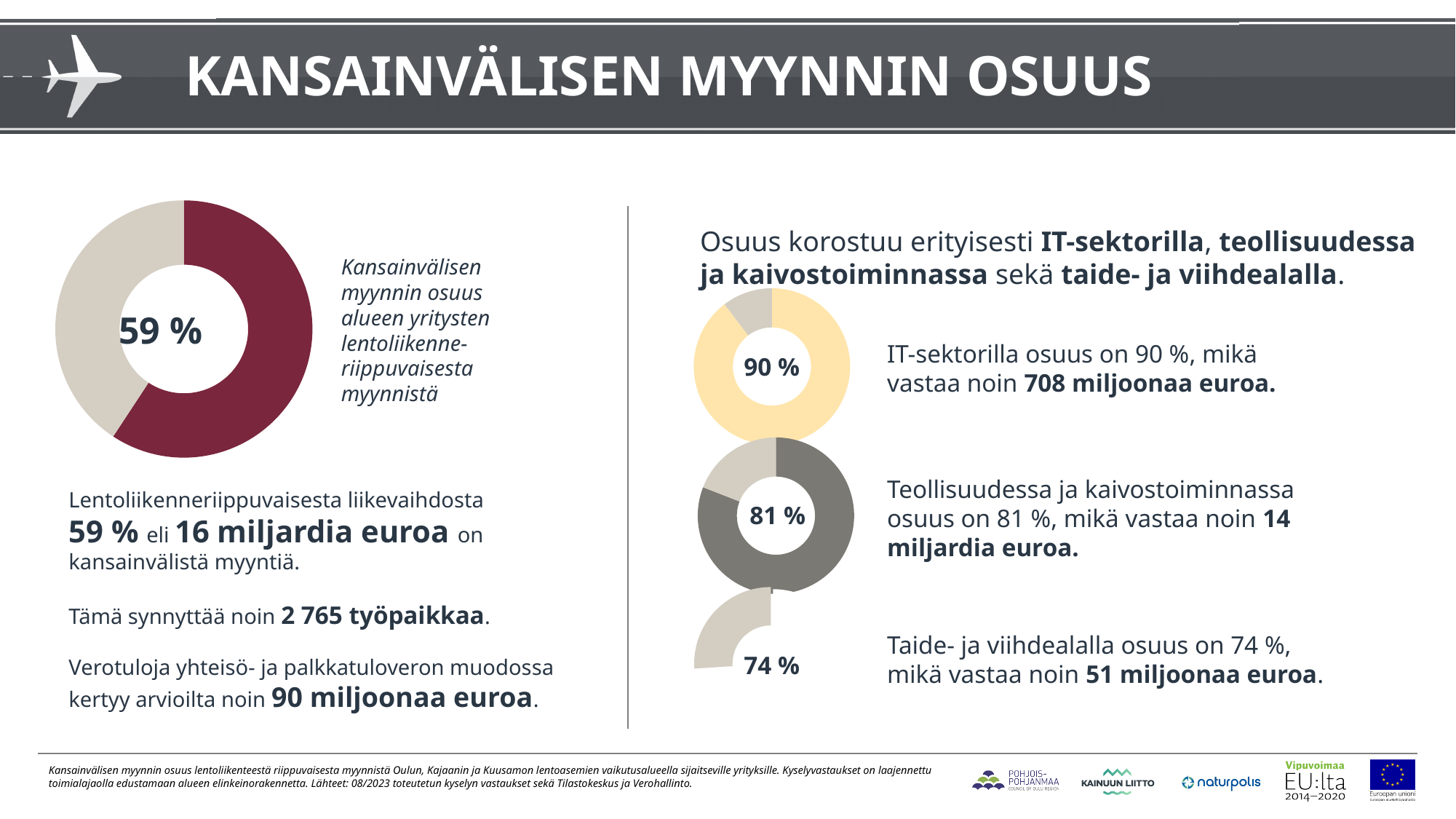
In the large donut chart on the left, what colour is the segment representing the 59 % share? Dark red (burgundy) Among the three sector donut charts on the right, which sector has the highest share of international sales? IT-sektori Among the three sector donut charts on the right, which sector has the lowest share of international sales? Taide- ja viihdeala In the donut charts on the right, which has the larger share: Teollisuus ja kaivostoiminta or Taide- ja viihdeala? Teollisuus ja kaivostoiminta What kind of chart is the large chart on the left of the slide? Donut (pie) chart In the large donut chart on the left, what share is represented by the grey (non-international) segment? 41 % How many donut charts are shown on the slide in total? 4 In the donut charts on the right, how many percentage points higher is the IT-sektori share than the Teollisuus ja kaivostoiminta share? 9 percentage points In the large donut chart on the left, what share of aviation-dependent sales is international sales? 59 % In the IT-sektori donut chart on the right, what is the share of international sales? 90 % In the Teollisuus ja kaivostoiminta donut chart on the right, what is the share of international sales? 81 % In the Taide- ja viihdeala donut chart on the right, what is the share of international sales? 74 %